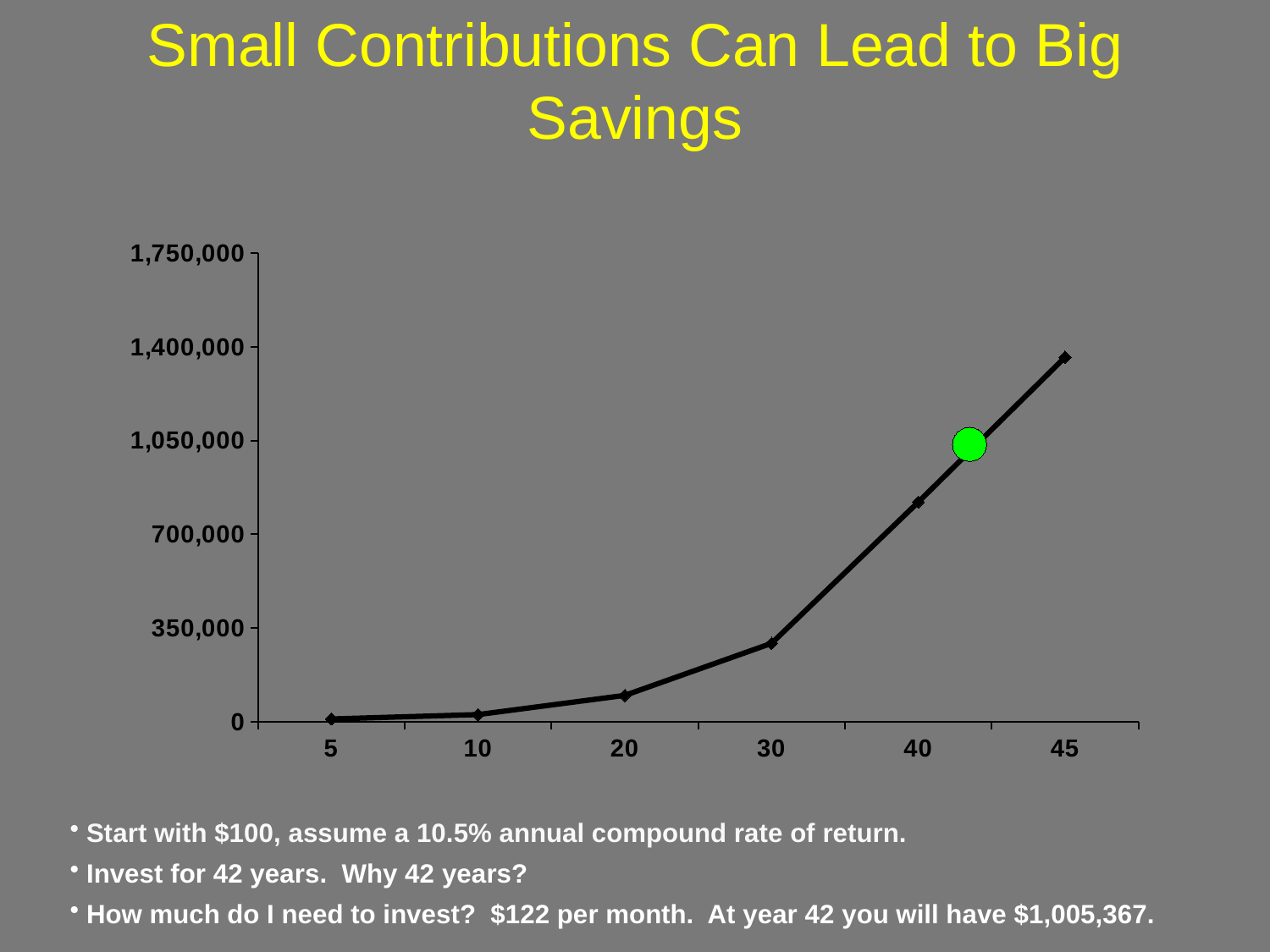
Which x-axis value has the lowest plotted value? 5 Which x-axis value has the highest plotted value? 45 Which has the larger plotted value, 40 or 30? 40 Is the value at 30 greater or less than 350,000? less Is the value at 40 greater or less than 700,000? greater Is the value at 20 greater or less than 350,000? less What kind of chart is shown on the slide? line chart Do the plotted values rise or fall as the x axis goes from 5 to 45? rise What is the title of the slide containing the chart? Small Contributions Can Lead to Big Savings How many lines (series) are plotted on the chart? 1 How many data points are plotted on the line? 6